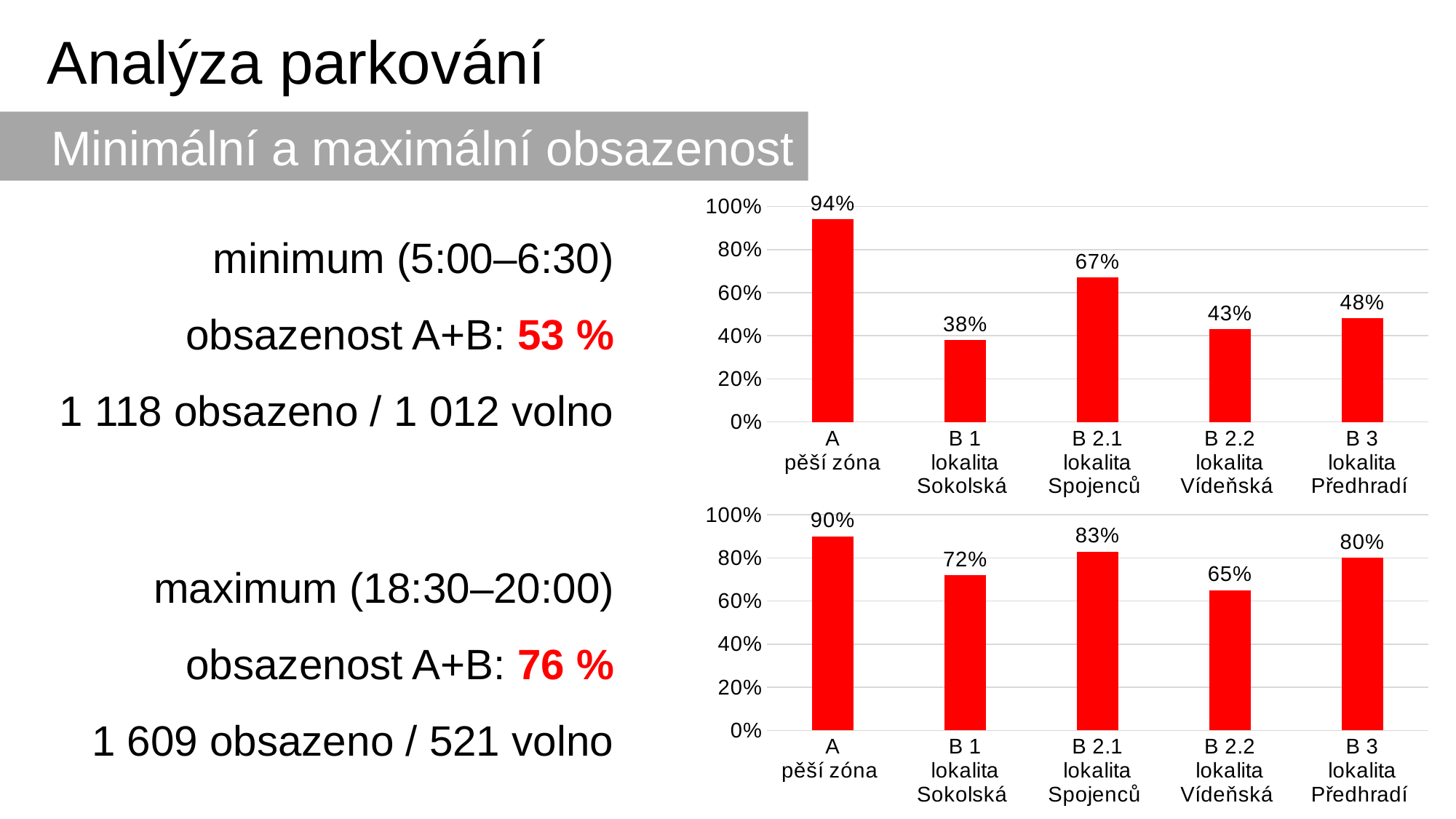
What colour are the bars in the top chart? red In the bottom chart, is the value for B 2.2 lokalita Vídeňská greater or less than 60%? greater In the bottom chart, which category has the lowest value? B 2.2 lokalita Vídeňská In the top chart, which category has the lowest value? B 1 lokalita Sokolská What kind of chart is the bottom chart? bar chart In the top chart, which is larger: the value for B 2.2 lokalita Vídeňská or B 3 lokalita Předhradí? B 3 lokalita Předhradí In the bottom chart, what is the value for B 1 lokalita Sokolská? 72% How many categories are shown in the top chart? 5 In the top chart, what is the value for B 2.1 lokalita Spojenců? 67% In the top chart, what is the difference between the values for A pěší zóna and B 1 lokalita Sokolská? 56% In the bottom chart, what is the difference between the values for B 2.1 lokalita Spojenců and B 3 lokalita Předhradí? 3% In the bottom chart, which category has the highest value? A pěší zóna